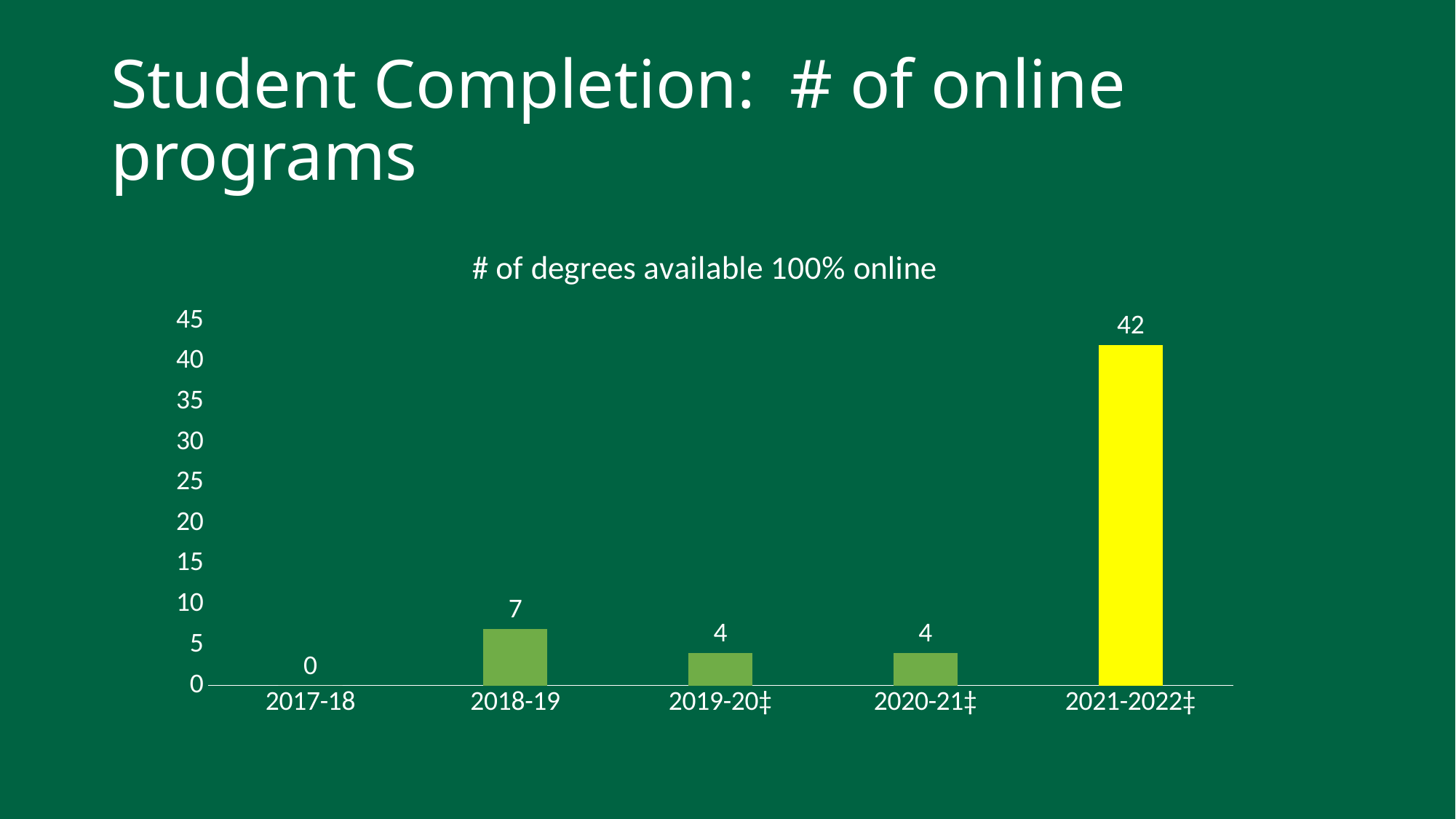
What kind of chart is shown? bar chart What is the value for 2017-18? 0 Which is larger, the value for 2018-19 or the value for 2019-20‡? 2018-19 Is the value for 2021-2022‡ greater or less than 40? greater What is the value for 2021-2022‡? 42 What colour is the bar for 2021-2022‡? yellow Which category has the lowest value? 2017-18 How many categories are shown on the x axis? 5 What is the value for 2018-19? 7 What is the title of the chart? # of degrees available 100% online Which category has the highest value? 2021-2022‡ What is the difference between the values for 2021-2022‡ and 2018-19? 35